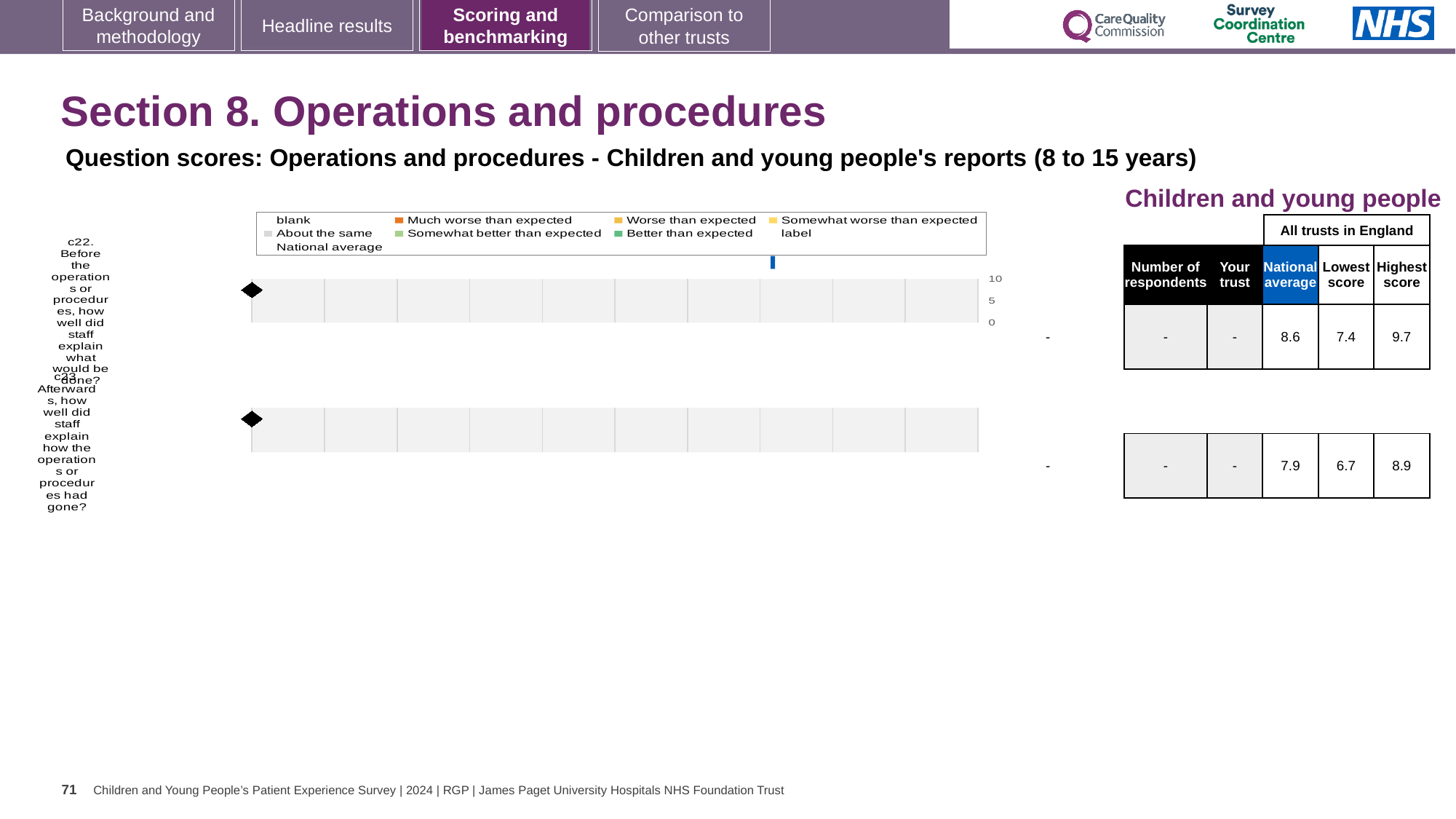
What is the subtitle above the chart describing the question scores? Question scores: Operations and procedures - Children and young people's reports (8 to 15 years) What value is shown for 'Your trust' for c22 in the table? - How many questions (categories) are listed on the chart's vertical axis? 2 What is the highest value shown on the chart's horizontal axis? 10 How many entries does the chart legend list? 9 In the table, what is the national average score for c23 (Afterwards, how well did staff explain how the operations or procedures had gone?)? 7.9 In the table, what is the lowest score among all trusts in England for c22? 7.4 What is the difference between the highest and lowest scores for c22 in the table? 2.3 In the table, what is the national average score for c22 (Before the operations or procedures, how well did staff explain what would be done?)? 8.6 What kind of chart is shown on the slide? bar chart Which question has the higher national average, c22 or c23? c22 In the table, what is the highest score among all trusts in England for c23? 8.9